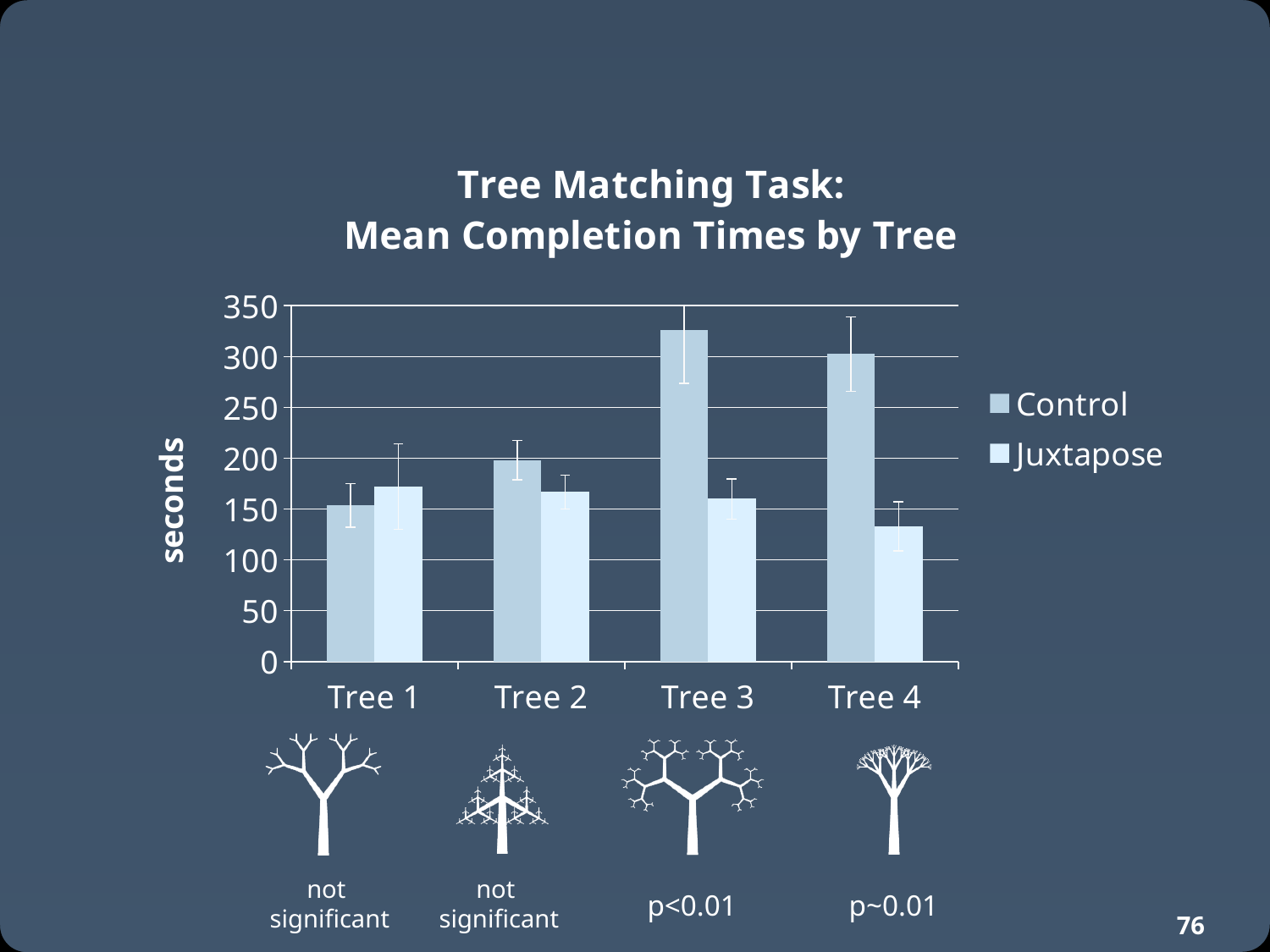
How many series does the legend list? 2 Is the Juxtapose value for Tree 4 greater or less than 150? less Is the Juxtapose value for Tree 3 greater or less than 200? less For Tree 2, which series has the larger value, Control or Juxtapose? Control For Tree 4, which series has the larger value, Control or Juxtapose? Control How many tree categories are shown on the x axis? 4 What kind of chart is shown on the slide? bar chart Which tree has the highest Control completion time? Tree 3 Which tree has the lowest Control completion time? Tree 1 What is the label on the y axis? seconds Is the Control value for Tree 3 greater or less than 300? greater Which tree has the lowest Juxtapose completion time? Tree 4